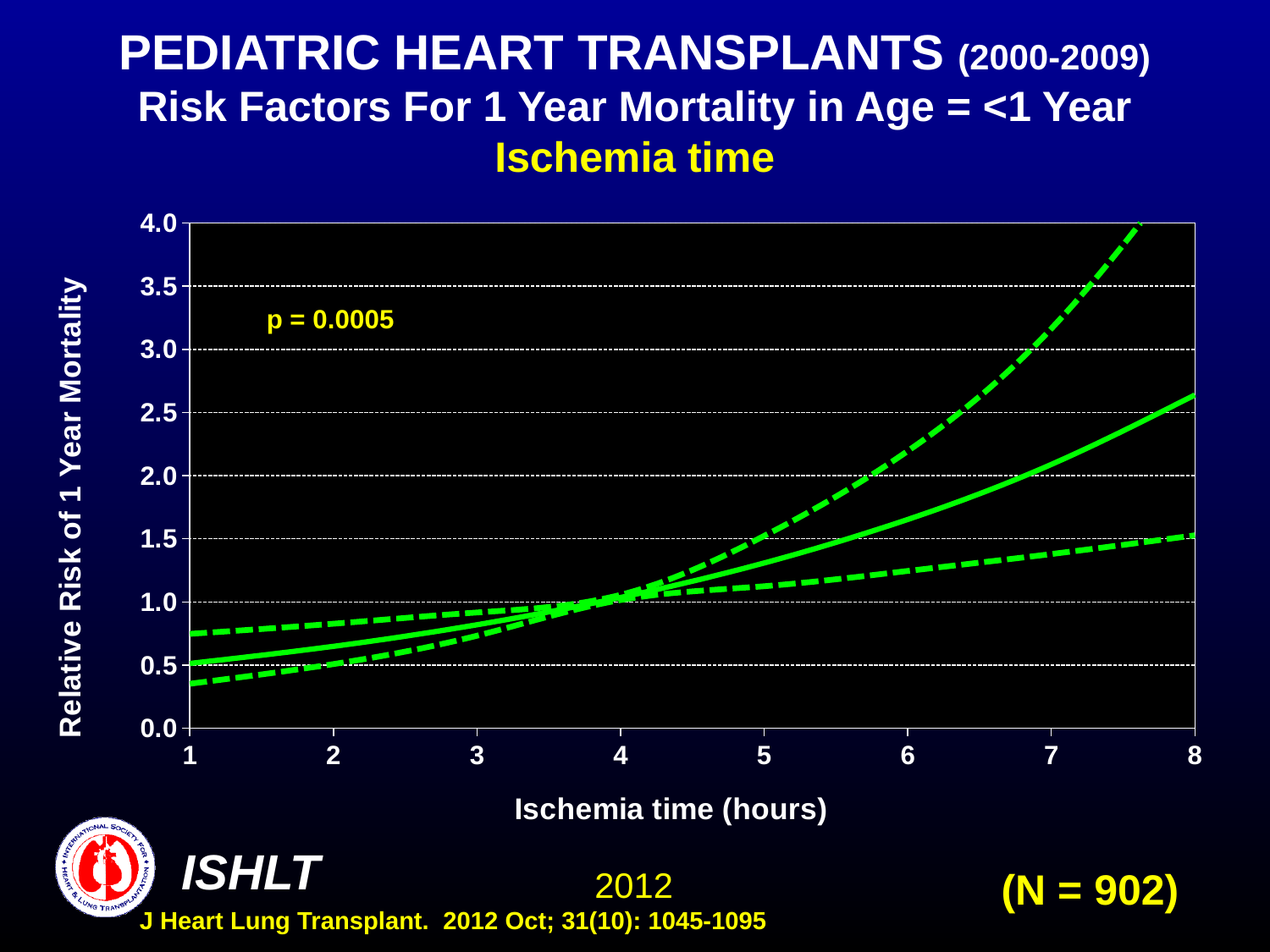
How many lines are plotted on the chart? 3 Is the relative risk shown by the solid line at 1 hour of ischemia time greater or less than 1.0? less Does the solid line for relative risk of 1 year mortality rise or fall as ischemia time increases from 1 to 8 hours? rise What p-value is printed on the chart? p = 0.0005 What is the range of ischemia time shown on the x axis? 1 to 8 hours Is the relative risk shown by the solid line at 8 hours of ischemia time greater or less than 2.0? greater Is the value of the upper dashed line at 7 hours of ischemia time greater or less than 2.0? greater What is the label of the x axis of the chart? Ischemia time (hours) What kind of chart is shown on the slide? line chart What is the highest value shown on the y axis of the chart? 4.0